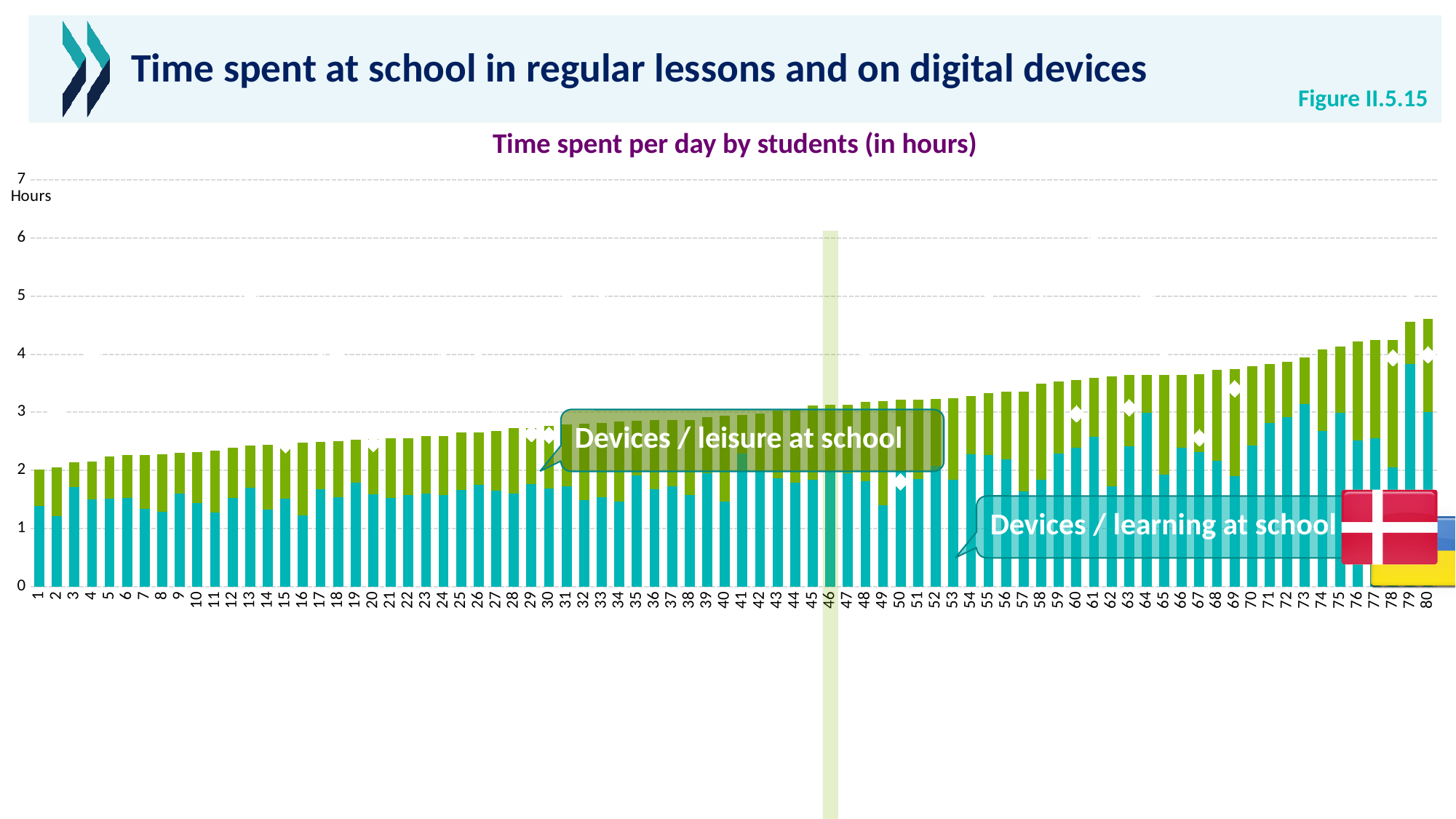
Is the total value for category 1 greater or less than 3? less Is the total value for category 60 greater or less than 3? greater Do the total bar heights rise or fall from category 1 to category 80? Rise Is the total value for category 20 greater or less than 3? less Which has the larger total bar, category 80 or category 1? 80 What kind of chart is shown on the slide? Stacked bar chart Which category has the highest total bar? 80 What are the two stacked series labelled in the callouts? Devices / leisure at school; Devices / learning at school Which category has the lowest total bar? 1 What is the chart's subtitle above the plot area? Time spent per day by students (in hours) How many numbered categories are plotted along the x axis? 80